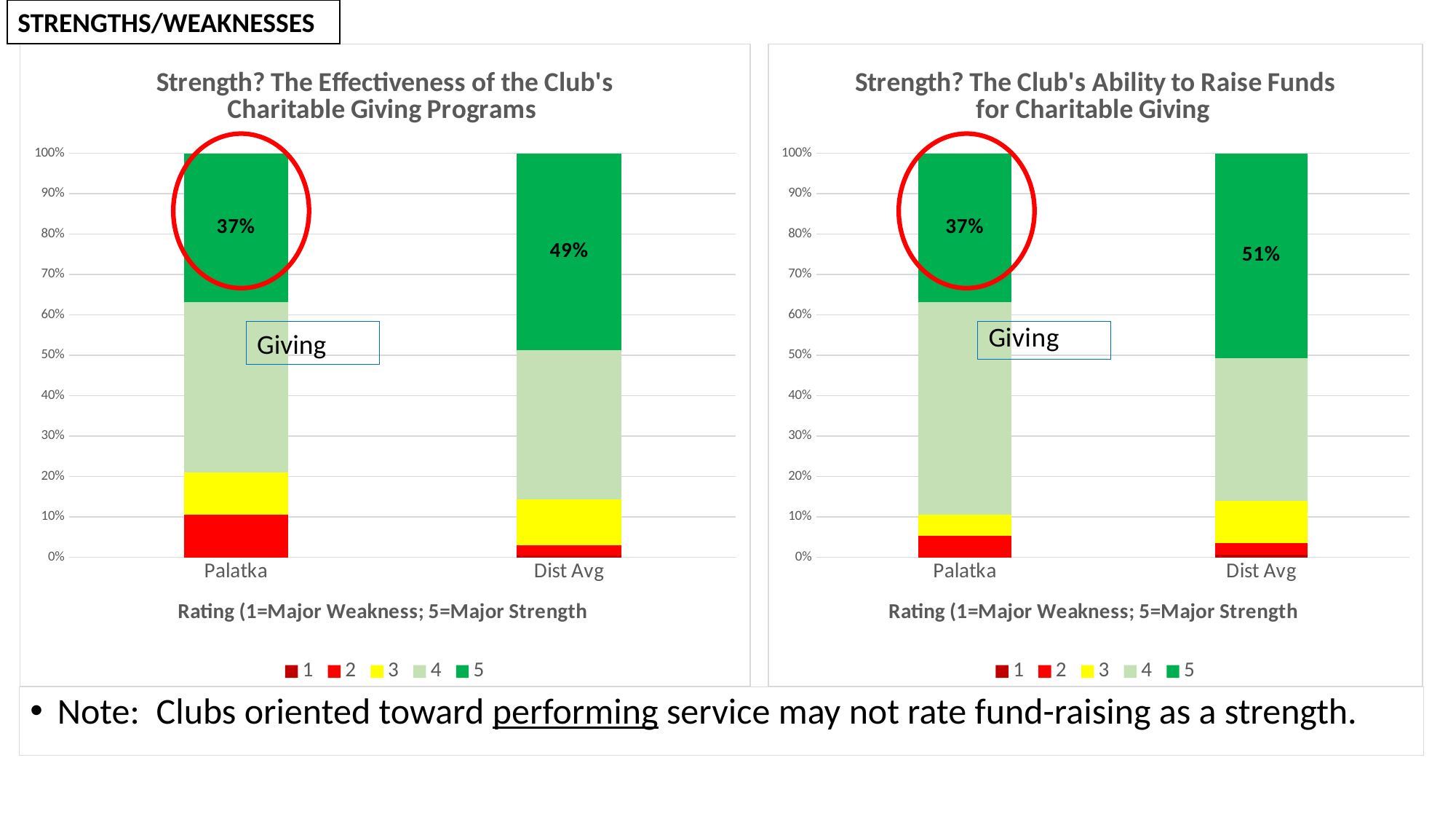
In the right chart (Club's Ability to Raise Funds for Charitable Giving), what percentage of Dist Avg ratings are a 5? 51% How many categories are shown on the x axis of the right chart? 2 In the left chart (Effectiveness of the Club's Charitable Giving Programs), what percentage of Palatka's ratings are a 5? 37% What kind of chart is the left chart? Stacked bar chart In the right chart (Club's Ability to Raise Funds for Charitable Giving), what percentage of Palatka's ratings are a 5? 37% How many series does the legend of the left chart list? 5 In the right chart, is the share of 2 ratings for Dist Avg greater or less than 10%? less In the left chart (Effectiveness of the Club's Charitable Giving Programs), what percentage of Dist Avg ratings are a 5? 49% In the right chart, how much larger is the Dist Avg share of 5 ratings than Palatka's share of 5 ratings? 14% In the left chart, how much larger is the Dist Avg share of 5 ratings than Palatka's share of 5 ratings? 12% In the left chart, is the share of 4 ratings for Dist Avg greater or less than 30%? greater In the right chart, which has the larger share of 5 ratings, Palatka or Dist Avg? Dist Avg